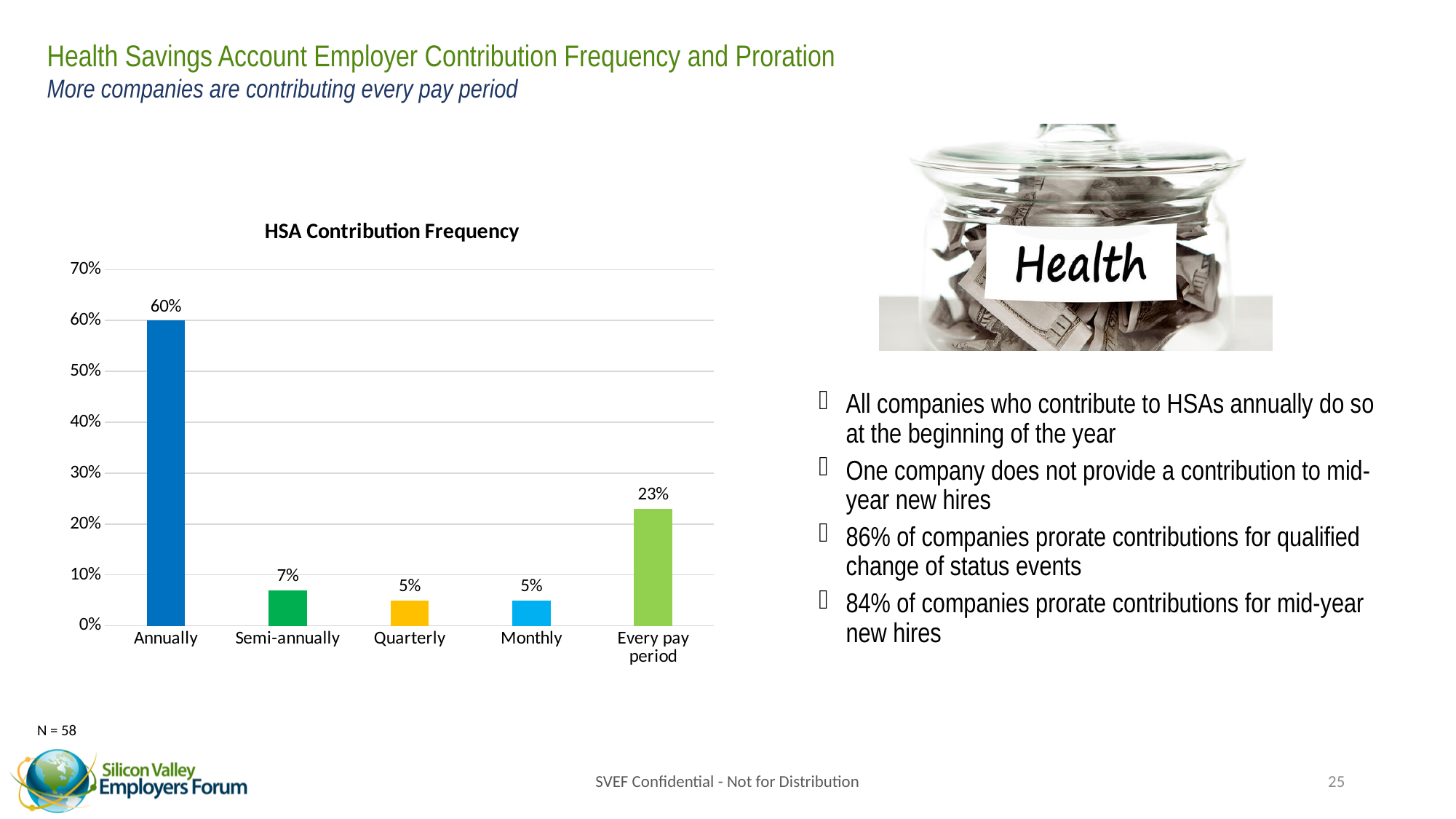
Is the value for Every pay period greater or less than 20% in the HSA Contribution Frequency chart? greater What kind of chart is the HSA Contribution Frequency chart? Bar chart Which category has the highest value in the HSA Contribution Frequency chart? Annually What is the highest value shown on the y axis of the HSA Contribution Frequency chart? 70% What is the value for Every pay period in the HSA Contribution Frequency chart? 23% What is the title of the chart on the slide? HSA Contribution Frequency What is the difference between the Annually and Every pay period values in the HSA Contribution Frequency chart? 37% What is the value for Annually in the HSA Contribution Frequency chart? 60% What is the difference between the Semi-annually and Quarterly values in the HSA Contribution Frequency chart? 2% What is the value for Semi-annually in the HSA Contribution Frequency chart? 7% How many categories are shown in the HSA Contribution Frequency chart? 5 Which is larger in the HSA Contribution Frequency chart, Semi-annually or Monthly? Semi-annually